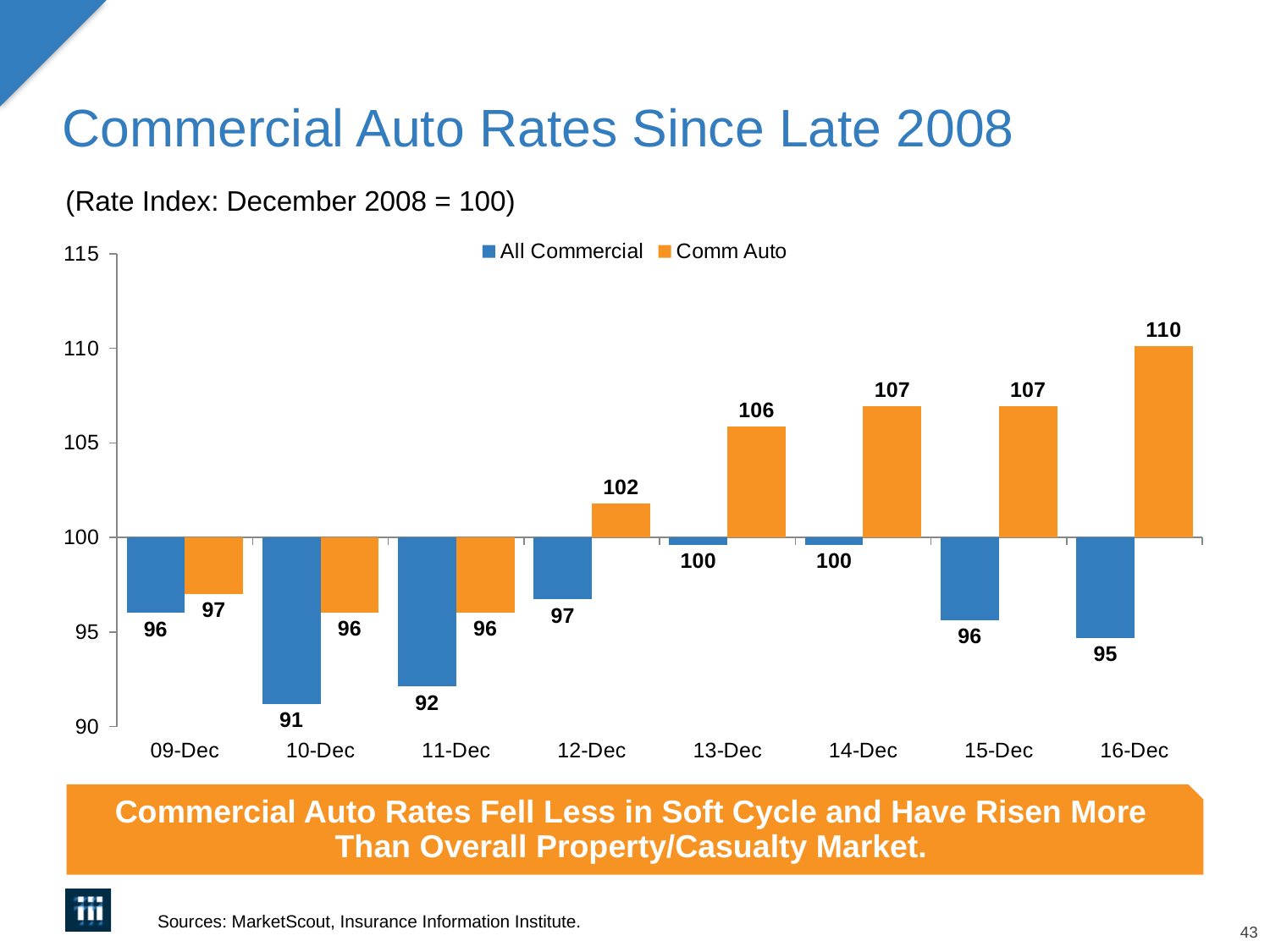
What is the All Commercial value for 10-Dec? 91 How many series does the legend list? 2 What is the Comm Auto value for 16-Dec? 110 For 12-Dec, which series has the larger value, All Commercial or Comm Auto? Comm Auto Do the Comm Auto values rise or fall from 12-Dec to 16-Dec? Rise What is the difference between the Comm Auto and All Commercial values for 16-Dec? 15 In which period is the Comm Auto value highest? 16-Dec What kind of chart is shown on the slide? Bar chart How many periods are shown on the x axis? 8 By how much did the Comm Auto value increase from 11-Dec to 12-Dec? 6 What is the All Commercial value for 13-Dec? 100 In which period is the All Commercial value lowest? 10-Dec